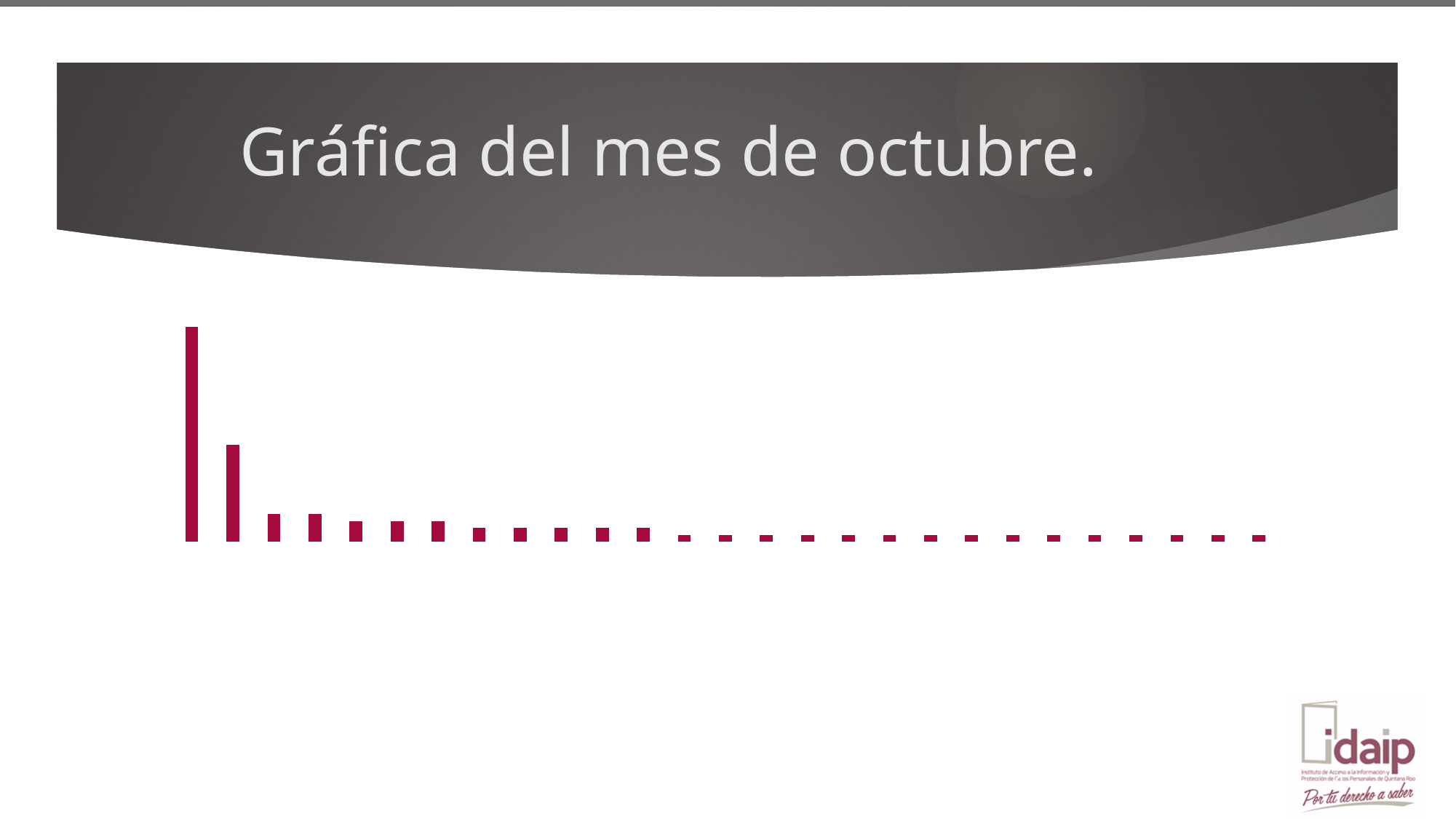
Which bar in the chart is the tallest? The first (leftmost) bar What colour are the bars in the chart? Dark red (magenta) What kind of chart is shown on the slide? Bar chart Which is taller, the first bar or the second bar from the left? The first bar What is the title of the slide containing the chart? Gráfica del mes de octubre. Do the bar values rise or fall from left to right across the chart? Fall How many bars are plotted in the chart? 27 Does the chart display any axis labels or data labels? No